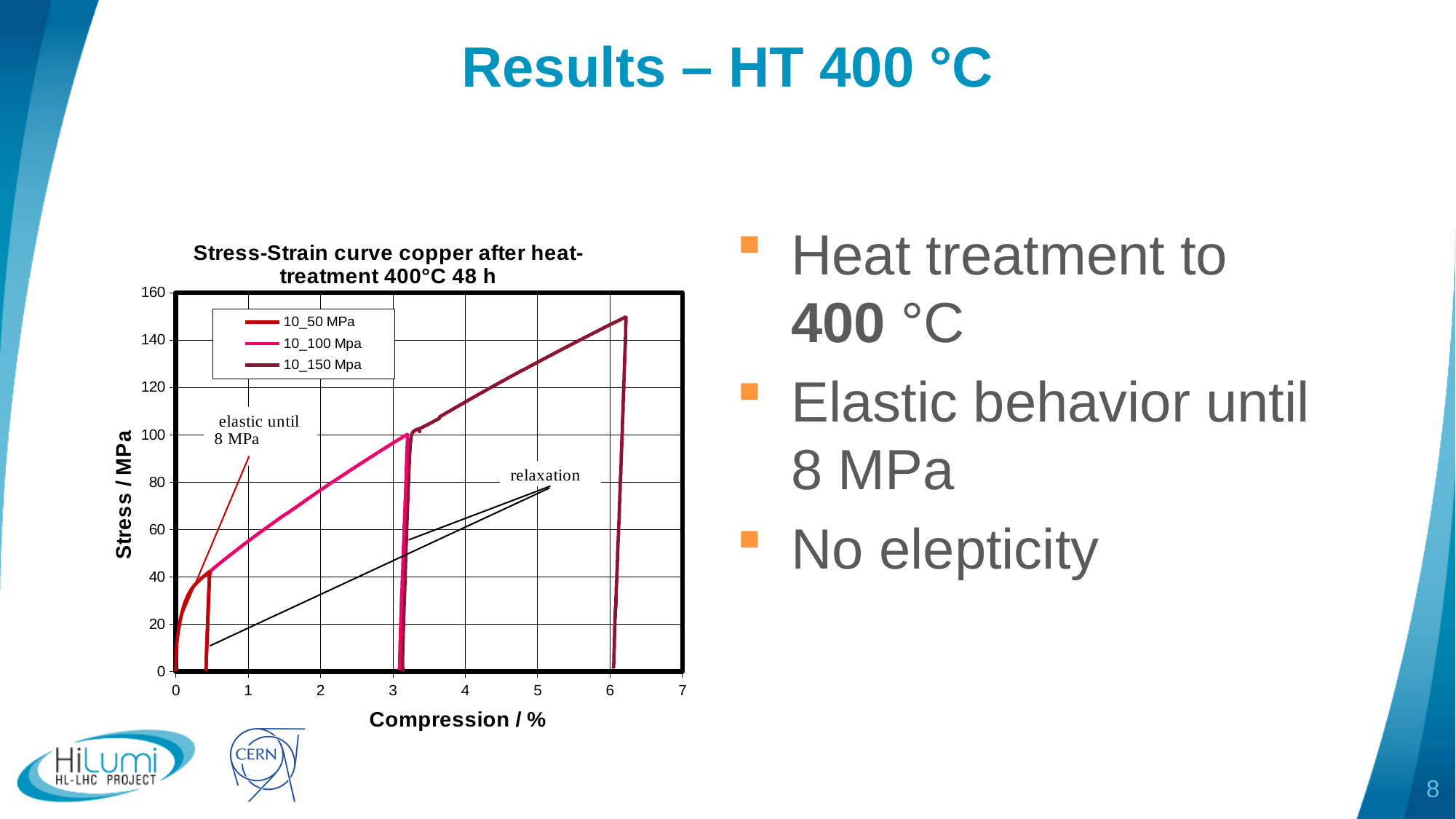
What is the highest value shown on the x axis (Compression / %)? 7 What is the label of the y axis of the chart? Stress / MPa Along the loading curve, does stress rise or fall as compression increases? rise What is the title of the chart? Stress-Strain curve copper after heat-treatment 400°C 48 h Is the peak stress of the 10_50 MPa series greater or less than 60? less How many series does the chart legend list? 3 Which series reaches the lowest peak stress in the chart? 10_50 MPa Is the peak stress of the 10_150 Mpa series greater or less than 140? greater What kind of chart is shown on the slide? line chart Which series reaches the highest stress in the chart? 10_150 Mpa Is the peak stress of the 10_100 Mpa series greater or less than 80? greater Which series reaches a higher peak stress, 10_100 Mpa or 10_50 MPa? 10_100 Mpa